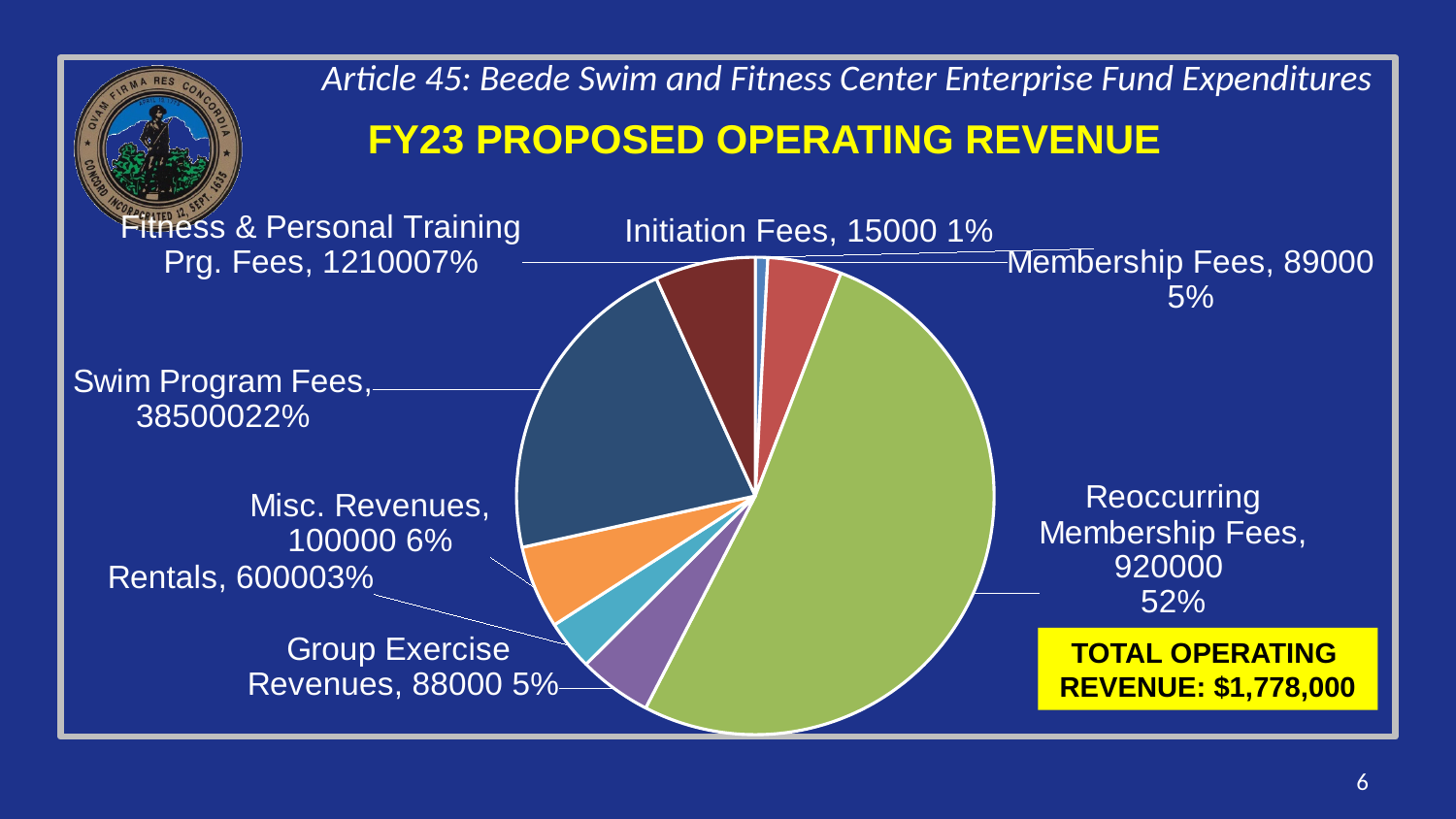
Which category has the smallest slice of the pie? Initiation Fees What share of the pie is Reoccurring Membership Fees? 52% Which is larger, Misc. Revenues or Group Exercise Revenues? Misc. Revenues What kind of chart is shown on the slide? pie chart What is the difference between the Membership Fees value and the Group Exercise Revenues value? 1000 What is the title of the chart? FY23 PROPOSED OPERATING REVENUE What total operating revenue is stated on the slide? $1,778,000 What is the value shown for Initiation Fees? 15000 What is the value shown for Reoccurring Membership Fees? 920000 Which category has the largest slice of the pie? Reoccurring Membership Fees What share of the pie is Misc. Revenues? 6% How many slices does the pie chart have? 8